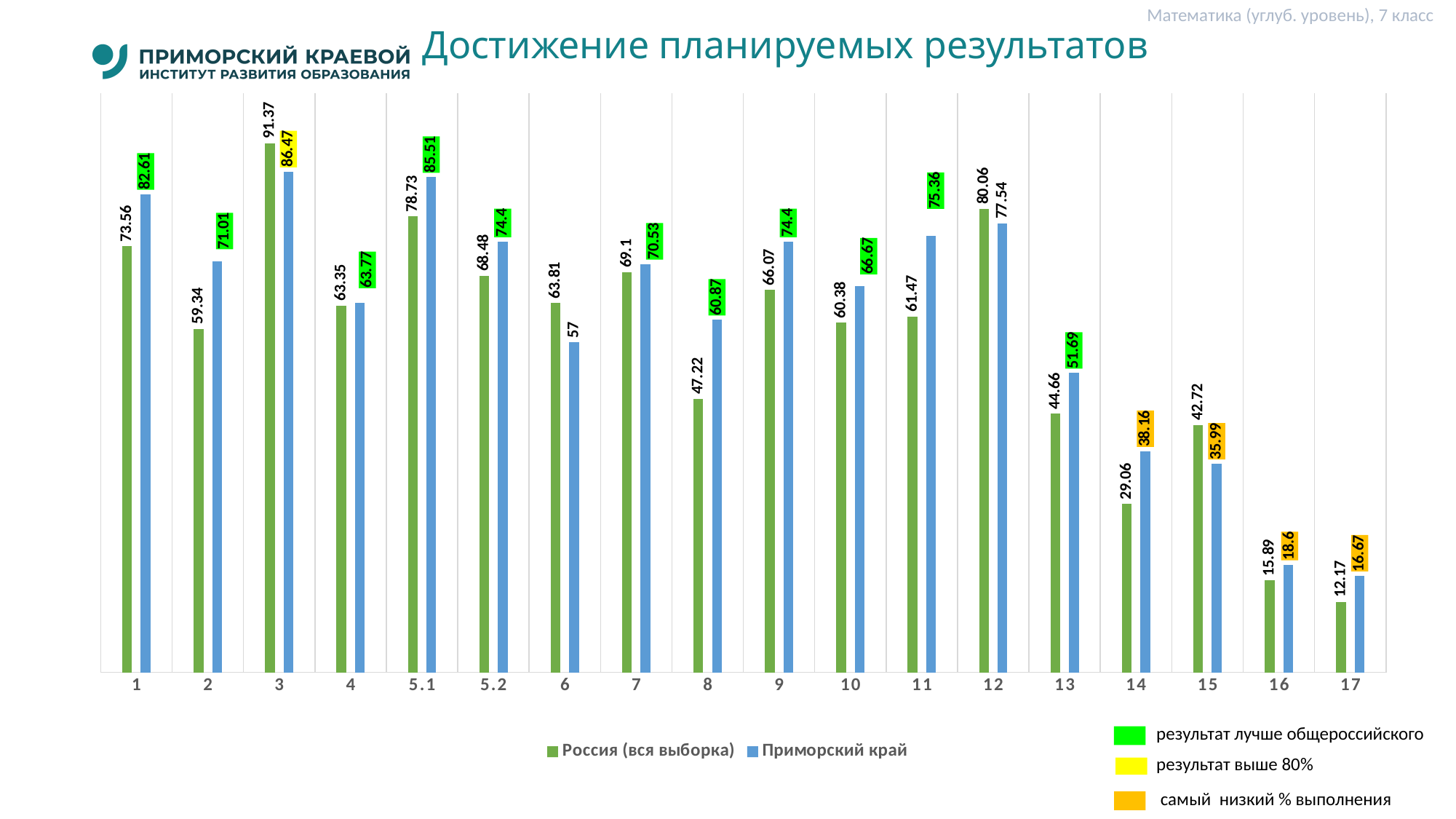
For task 15, which series has the larger value: Россия (вся выборка) or Приморский край? Россия (вся выборка) What is the title of the chart on the slide? Достижение планируемых результатов What is the difference between the Россия (вся выборка) values for task 3 and task 17? 79.2 Which task has the lowest value for Приморский край? 17 Which task has the highest value for Россия (вся выборка)? 3 What kind of chart is shown on the slide? bar chart What is the value for Россия (вся выборка) for task 12? 80.06 What is the value for Приморский край for task 1? 82.61 How many series does the chart legend list? 2 What is the difference between the Приморский край and Россия (вся выборка) values for task 8? 13.65 How many task categories are shown on the x axis? 18 What is the value for Приморский край for task 6? 57